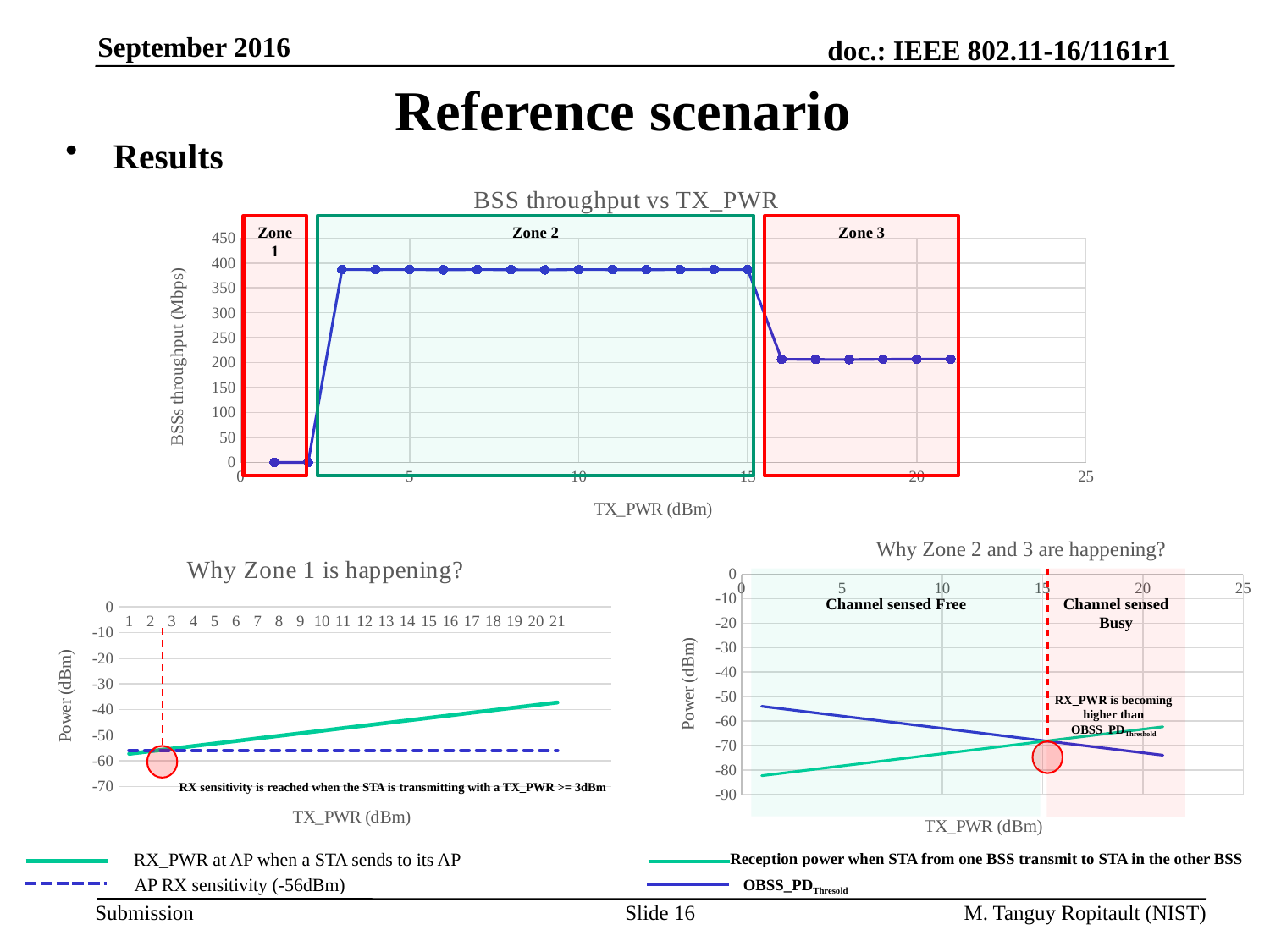
In the "BSS throughput vs TX_PWR" chart, is the throughput at TX_PWR 10 dBm greater or less than 350 Mbps? greater In the "Why Zone 2 and 3 are happening?" chart, does the OBSS_PD Threshold line rise or fall as TX_PWR increases? fall What type of chart is the "BSS throughput vs TX_PWR" chart? Line chart What is the label of the y axis of the "BSS throughput vs TX_PWR" chart? BSSs throughput (Mbps) In the "BSS throughput vs TX_PWR" chart, is the throughput at TX_PWR 20 dBm greater or less than 250 Mbps? less How many series does the legend of the "Why Zone 1 is happening?" chart list? 2 In the "Why Zone 1 is happening?" chart, does the RX_PWR at AP rise or fall as TX_PWR increases? rise In the "BSS throughput vs TX_PWR" chart, is the throughput higher in Zone 2 or in Zone 3? Zone 2 In the "BSS throughput vs TX_PWR" chart, does the throughput rise or fall when moving from Zone 2 to Zone 3? fall In the "Why Zone 1 is happening?" chart, what is the AP RX sensitivity value given in the legend? -56dBm In the "BSS throughput vs TX_PWR" chart, is the throughput at TX_PWR 1 dBm greater or less than 50 Mbps? less